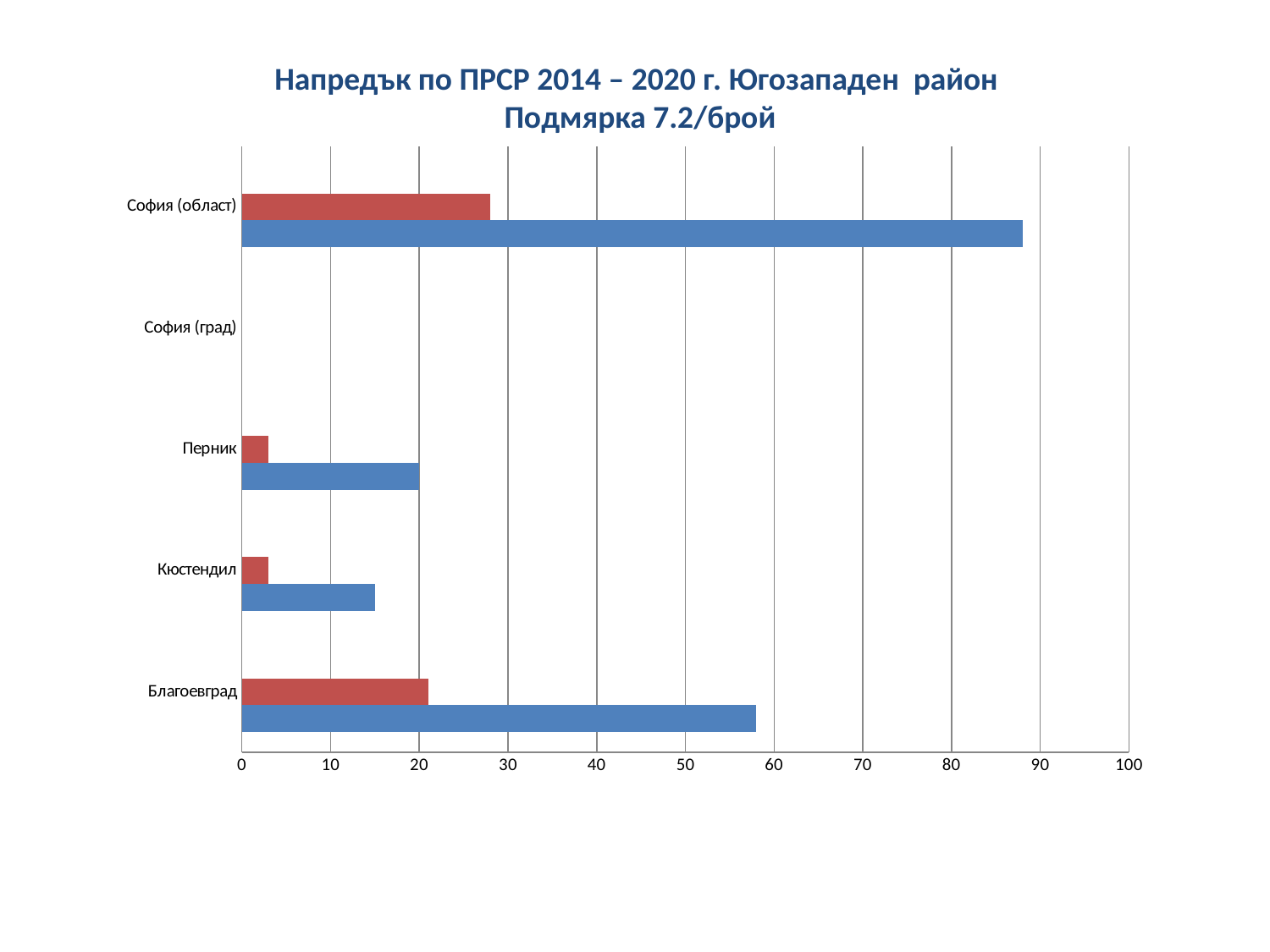
Which is larger, the blue bar for Благоевград or the blue bar for Перник? Благоевград Is the red bar for Перник greater or less than 10? less Which category has the longest red bar? София (област) Which category has the longest blue bar? София (област) Which category shows no bars at all? София (град) Is the blue bar for София (област) greater or less than 80? greater Is the blue bar for Кюстендил greater or less than 20? less What kind of chart is shown on the slide? bar chart What is the maximum value shown on the horizontal axis of the chart? 100 How many categories are shown on the vertical axis of the chart? 5